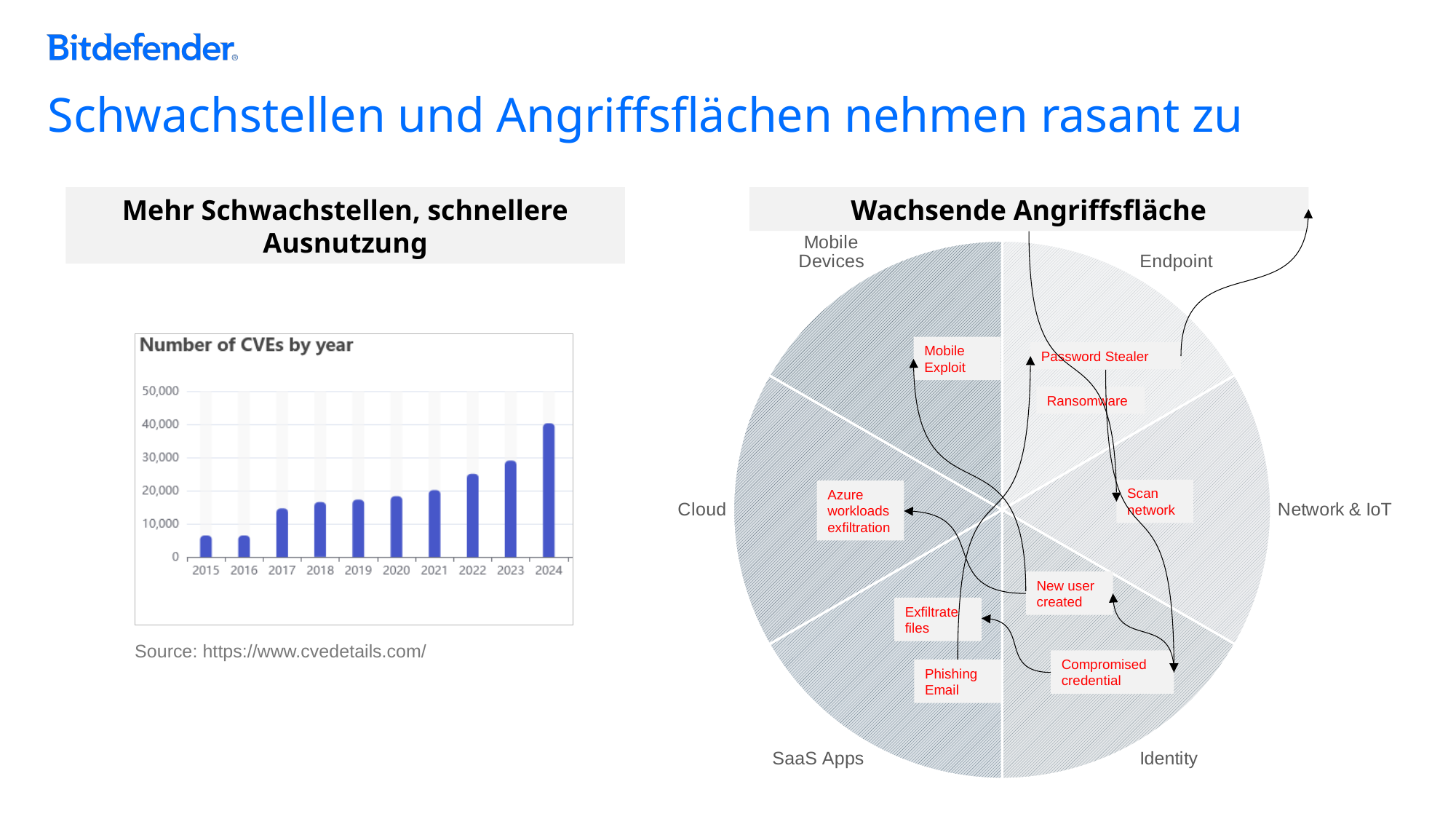
In the 'Number of CVEs by year' chart, which year has the larger value, 2017 or 2016? 2017 In the 'Number of CVEs by year' chart, do the values generally rise or fall from 2015 to 2024? rise What source is cited below the 'Number of CVEs by year' chart? https://www.cvedetails.com/ In the 'Number of CVEs by year' chart, which year has the larger value, 2023 or 2022? 2023 In the 'Number of CVEs by year' chart, is the value for 2017 greater or less than 10,000? greater What is the title of the bar chart on the left of the slide? Number of CVEs by year In the 'Number of CVEs by year' chart, which year has the highest number of CVEs? 2024 How many years are shown on the x axis of the 'Number of CVEs by year' chart? 10 In the 'Number of CVEs by year' chart, is the value for 2022 greater or less than 20,000? greater In the 'Number of CVEs by year' chart, is the value for 2024 greater or less than 30,000? greater What kind of chart is the 'Number of CVEs by year' chart on the left of the slide? bar chart